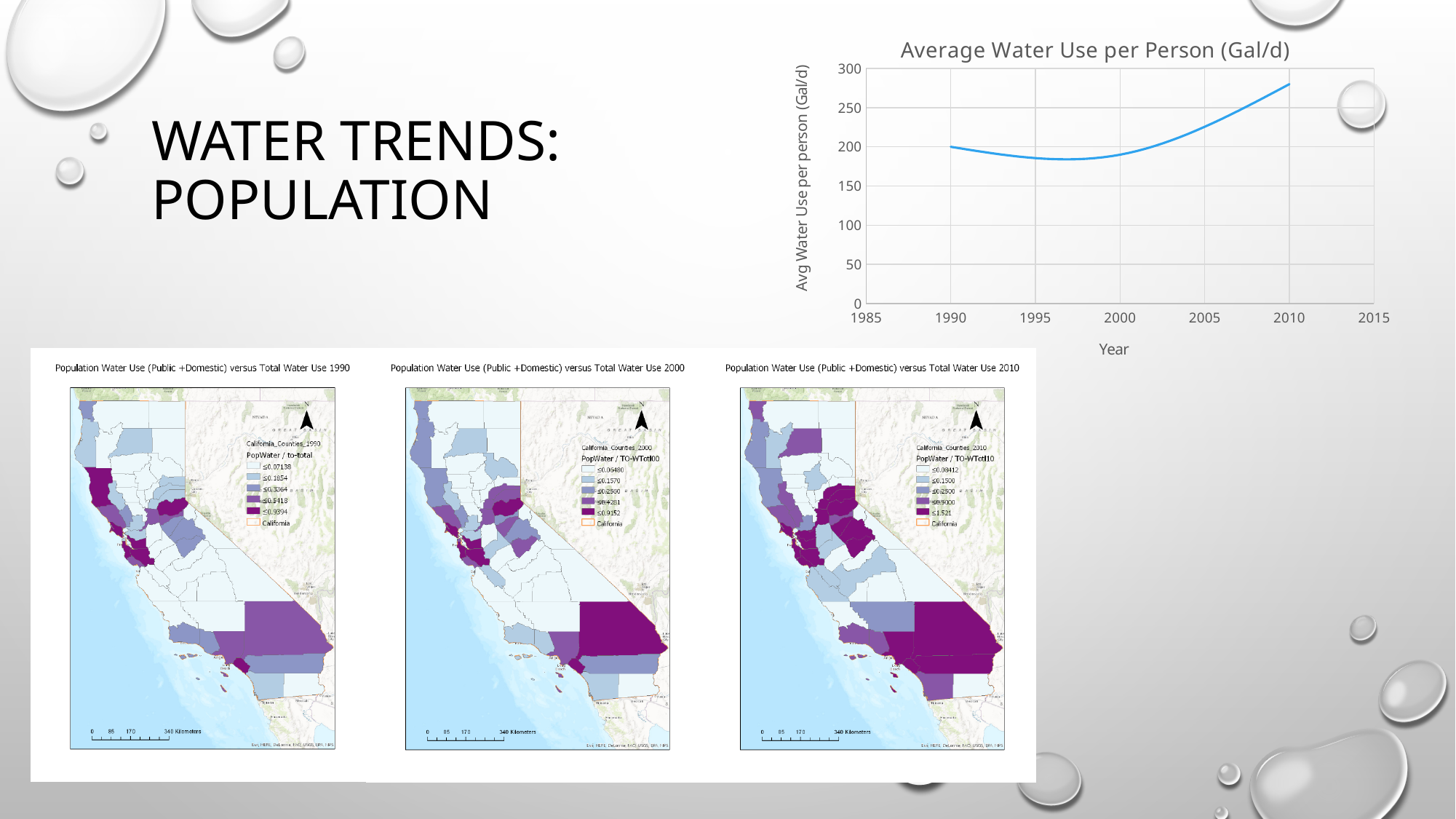
In the "Average Water Use per Person (Gal/d)" chart, which year has the higher value, 1990 or 2010? 2010 What is the x-axis label of the "Average Water Use per Person (Gal/d)" chart? Year In the "Average Water Use per Person (Gal/d)" chart, is the value for 2000 greater or less than 200? less What is the title of the chart at the top right of the slide? Average Water Use per Person (Gal/d) In the "Average Water Use per Person (Gal/d)" chart, of the years 1990, 2000 and 2010, which has the highest value? 2010 In the "Average Water Use per Person (Gal/d)" chart, is the value for 2010 greater or less than 250? greater What kind of chart is "Average Water Use per Person (Gal/d)"? line chart In the "Average Water Use per Person (Gal/d)" chart, is the value for 1990 greater or less than 150? greater In the "Average Water Use per Person (Gal/d)" chart, which year has the higher value, 1990 or 2000? 1990 In the "Average Water Use per Person (Gal/d)" chart, does the line rise or fall between 2000 and 2010? rise